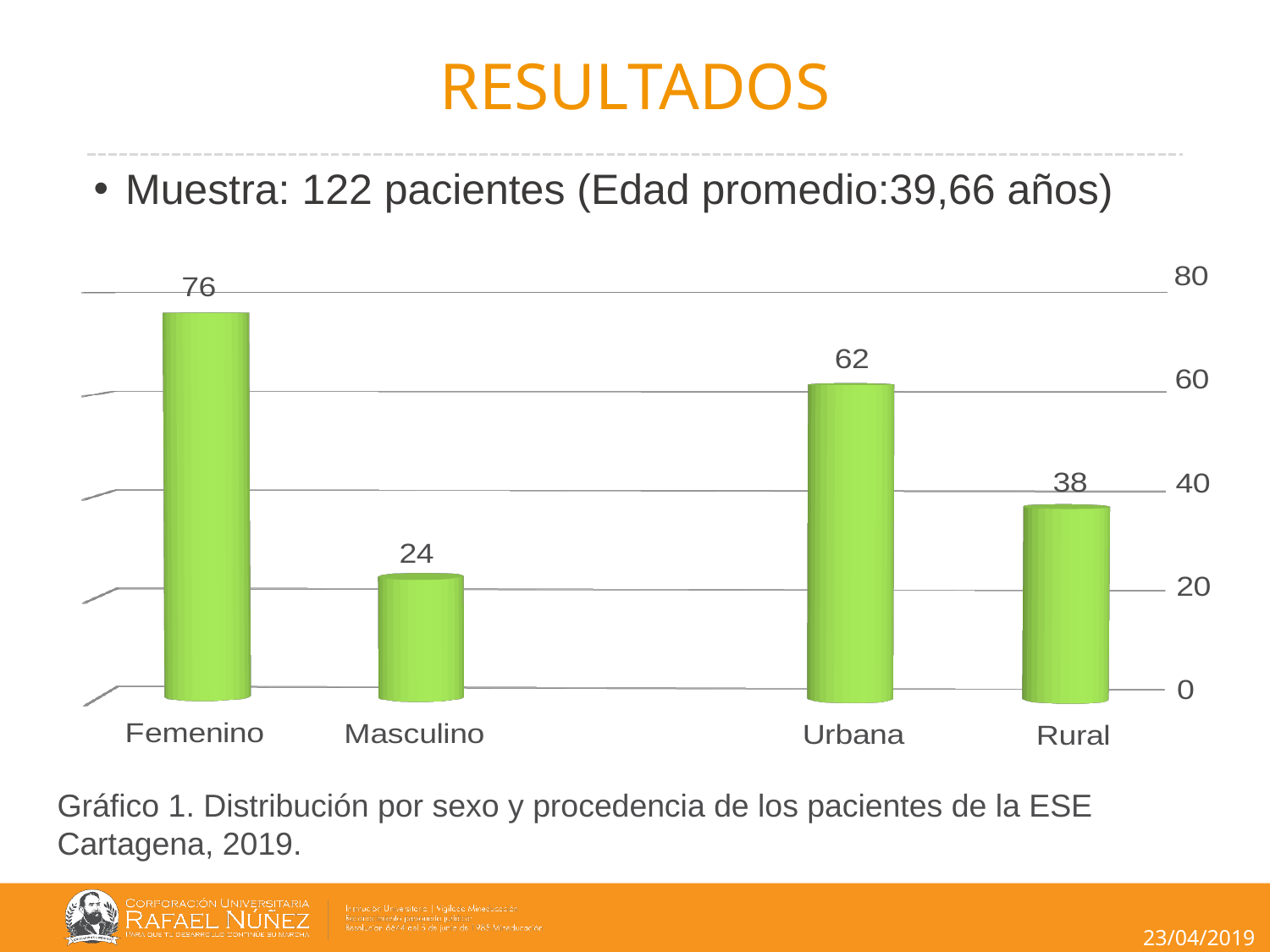
What is the value for Masculino? 24 What is the difference between the values for Femenino and Masculino? 52 How many categories are shown on the x axis? 4 What is the value for Femenino? 76 Which category has the highest value? Femenino What is the caption given for the chart below it? Gráfico 1. Distribución por sexo y procedencia de los pacientes de la ESE Cartagena, 2019. What is the value for Rural? 38 Which category has the lowest value? Masculino Which is larger, the value for Urbana or the value for Rural? Urbana What is the value for Urbana? 62 What is the difference between the values for Urbana and Rural? 24 What kind of chart is shown on the slide? Bar chart